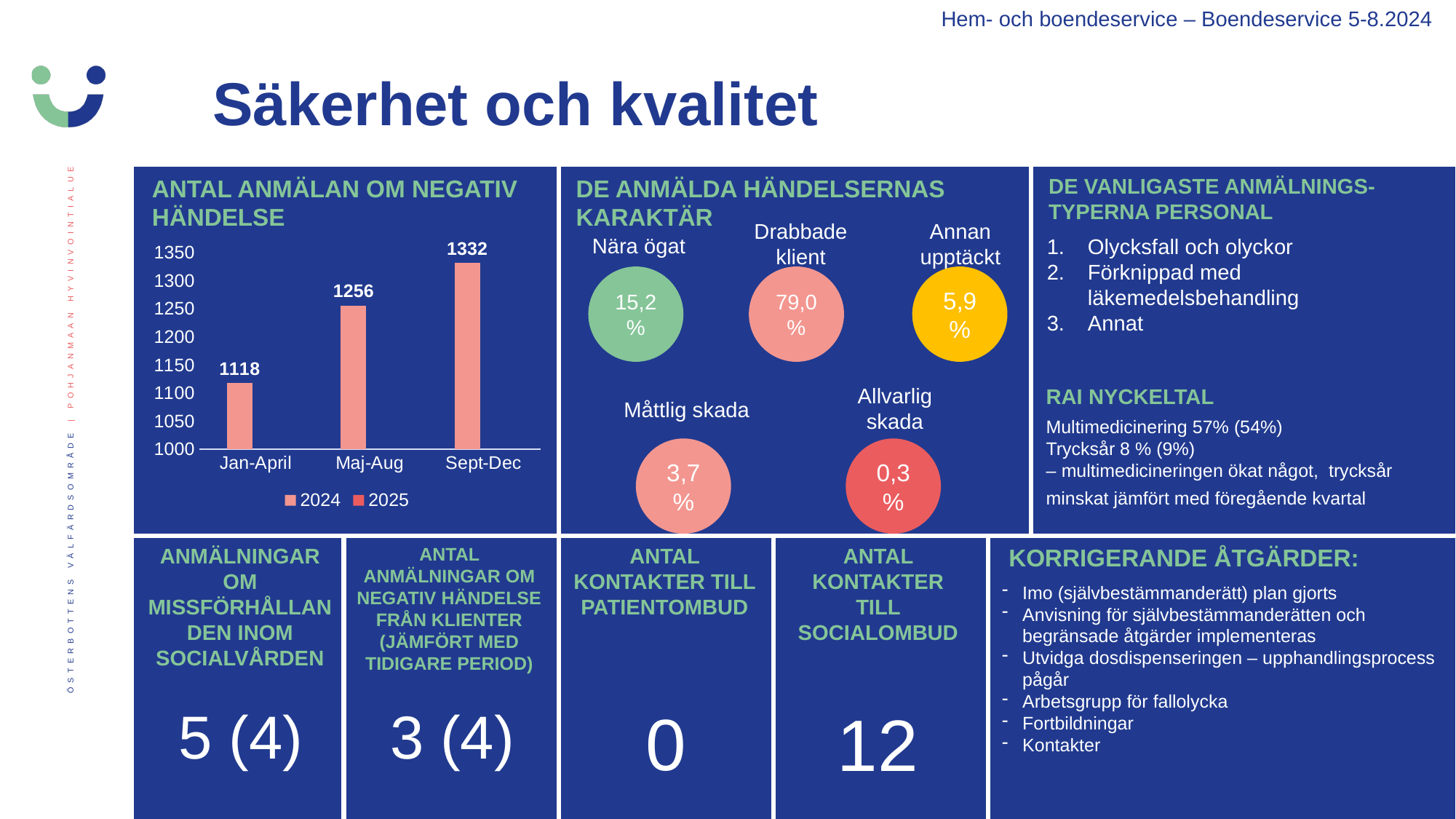
In the chart 'ANTAL ANMÄLAN OM NEGATIV HÄNDELSE', what is the difference between the Sept-Dec and Jan-April values? 214 How many series does the legend of the chart 'ANTAL ANMÄLAN OM NEGATIV HÄNDELSE' list? 2 In the chart 'ANTAL ANMÄLAN OM NEGATIV HÄNDELSE', what is the value for Maj-Aug? 1256 In the chart 'ANTAL ANMÄLAN OM NEGATIV HÄNDELSE', which is larger, the value for Maj-Aug or for Sept-Dec? Sept-Dec In the chart 'ANTAL ANMÄLAN OM NEGATIV HÄNDELSE', what is the value for Jan-April? 1118 In the chart 'ANTAL ANMÄLAN OM NEGATIV HÄNDELSE', is the value for Jan-April greater or less than 1150? less In the chart 'ANTAL ANMÄLAN OM NEGATIV HÄNDELSE', what is the difference between the Maj-Aug and Jan-April values? 138 How many periods are shown on the x axis of the chart 'ANTAL ANMÄLAN OM NEGATIV HÄNDELSE'? 3 Do the values in the chart 'ANTAL ANMÄLAN OM NEGATIV HÄNDELSE' rise or fall from Jan-April to Sept-Dec? rise In the chart 'ANTAL ANMÄLAN OM NEGATIV HÄNDELSE', what is the value for Sept-Dec? 1332 In the chart 'ANTAL ANMÄLAN OM NEGATIV HÄNDELSE', which period has the lowest value? Jan-April In the chart 'ANTAL ANMÄLAN OM NEGATIV HÄNDELSE', which period has the highest value? Sept-Dec